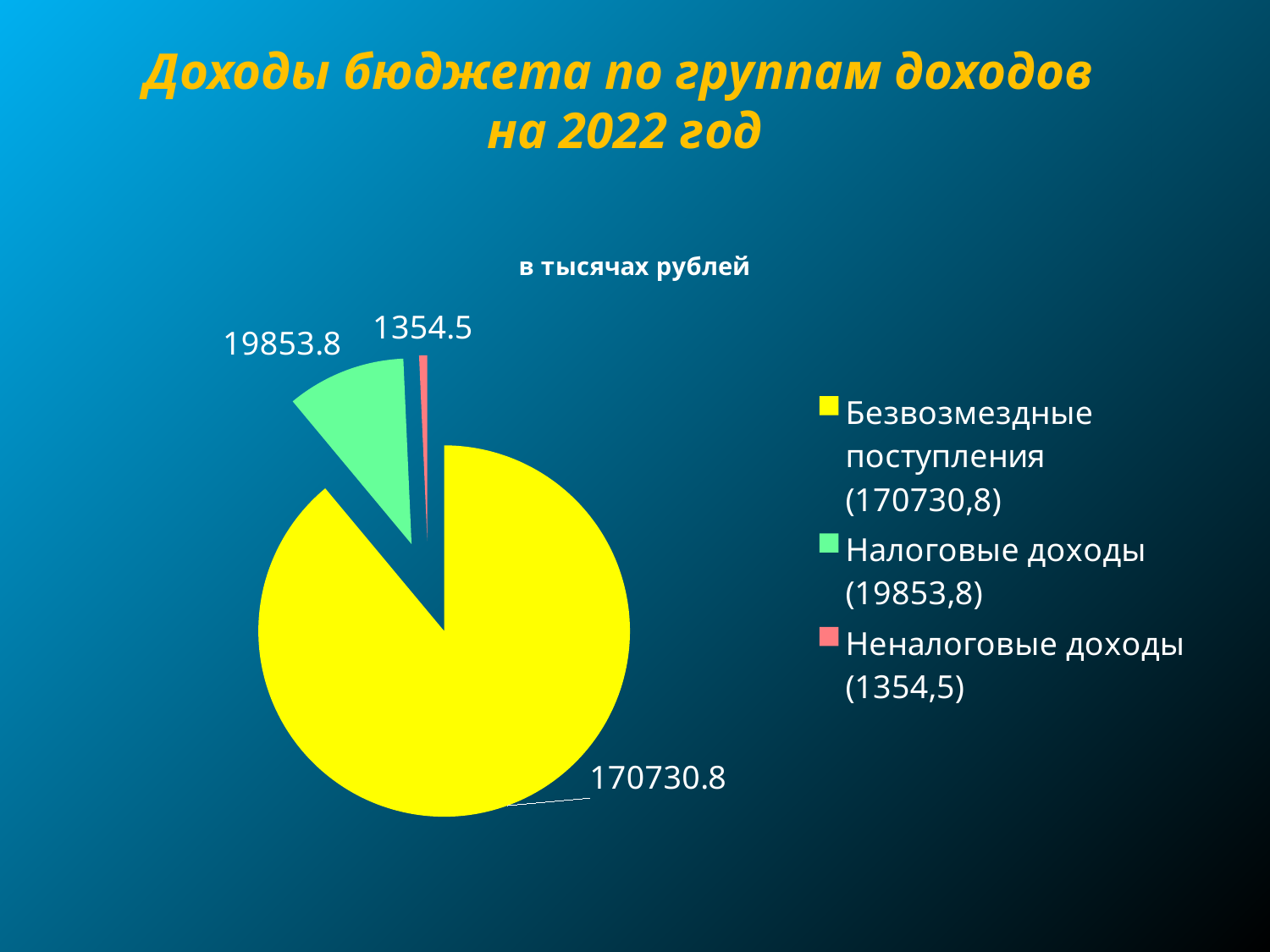
What is the value for Неналоговые доходы? 1354.5 How many entries does the legend list? 3 What is the value for Безвозмездные поступления? 170730.8 What is the difference between Безвозмездные поступления and Налоговые доходы? 150877.0 Which is larger, Налоговые доходы or Неналоговые доходы? Налоговые доходы Which category has the largest slice of the pie? Безвозмездные поступления What is the value for Налоговые доходы? 19853.8 Which category has the smallest slice of the pie? Неналоговые доходы What type of chart is shown on the slide? pie chart What unit is stated in the chart title? в тысячах рублей How many slices does the pie chart have? 3